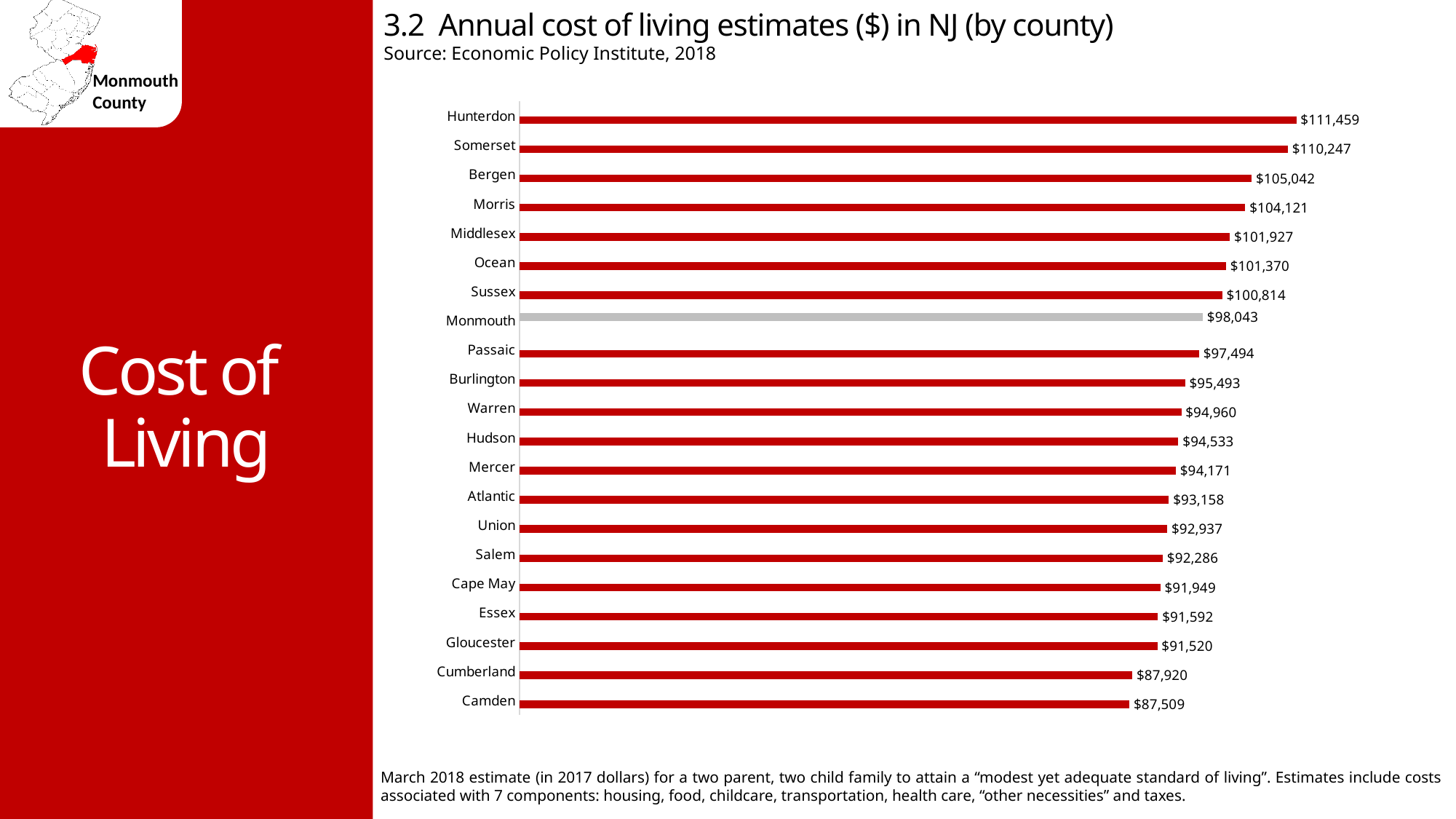
How many counties are shown in the chart? 21 What is the annual cost of living estimate for Bergen County? $105,042 Which county has a higher cost of living estimate, Ocean or Passaic? Ocean What is the annual cost of living estimate for Camden County? $87,509 Which county has the lowest annual cost of living estimate? Camden Which county's bar is shown in grey rather than red? Monmouth What is the annual cost of living estimate for Monmouth County? $98,043 What is the source cited for the chart? Economic Policy Institute, 2018 What is the difference between the cost of living estimates for Hunterdon and Somerset? $1,212 What is the difference between the cost of living estimates for Monmouth and Camden? $10,534 Which county has the highest annual cost of living estimate? Hunterdon What type of chart is shown on the slide? Bar chart